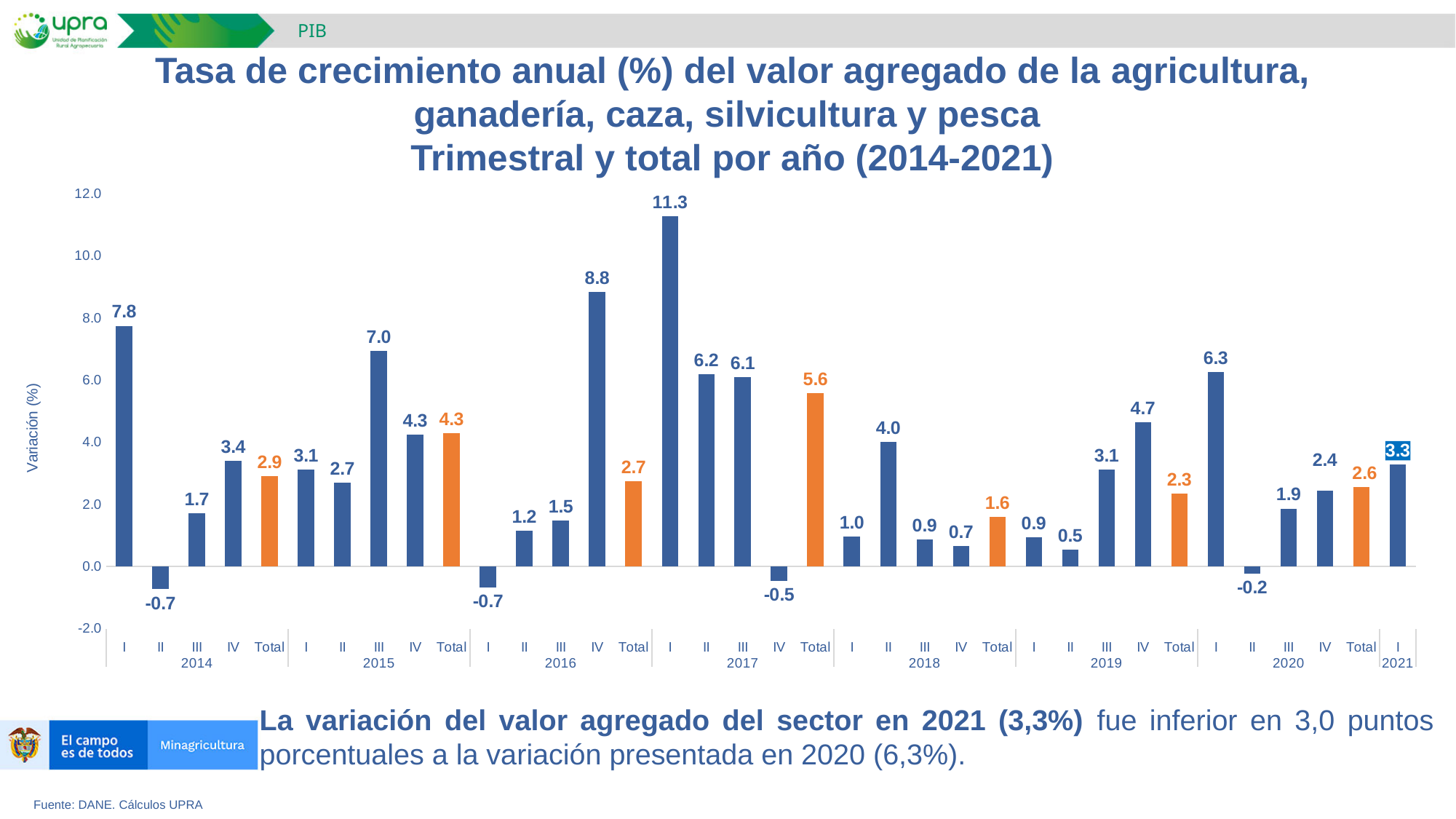
What type of chart is shown on the slide? Bar chart What is the value for quarter I of 2017? 11.3 What is the difference between the Total for 2017 and the Total for 2018? 4.0 What is the annual Total value for 2015? 4.3 Is the value for quarter I of 2014 greater or less than 6.0? greater Which annual Total is the lowest? 2018 (1.6) Which bar has the highest value in the chart? I 2017 Which is larger, the value for quarter IV of 2016 or quarter III of 2015? IV 2016 (8.8) Which bar has the lowest value in the chart? II 2014 (and I 2016), -0.7 How many bars are plotted in the chart? 36 What is the value for quarter I of 2021? 3.3 Which annual Total is the highest? 2017 (5.6)